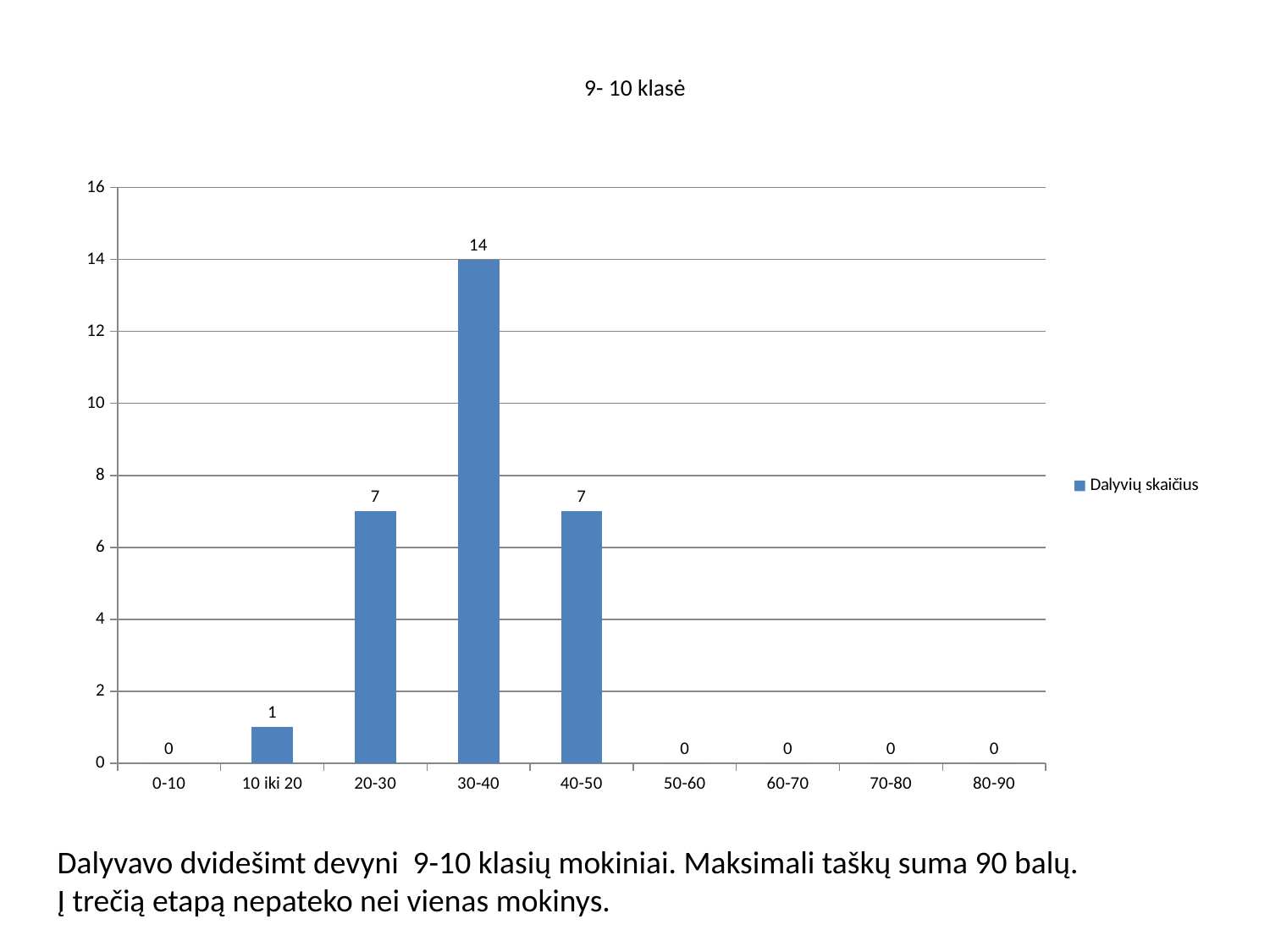
What is the value for the 10 iki 20 category? 1 Which category has the highest value? 30-40 How many categories are shown on the x axis? 9 What is the title of the chart? 9- 10 klasė What is the name of the series in the legend? Dalyvių skaičius What kind of chart is shown on the slide? bar chart What is the difference between the values for 30-40 and 40-50? 7 Is the value for 30-40 greater or less than 12? greater Which is larger, the value for 10 iki 20 or the value for 20-30? 20-30 How many series does the legend list? 1 What is the value for the 30-40 category? 14 What is the value for the 20-30 category? 7